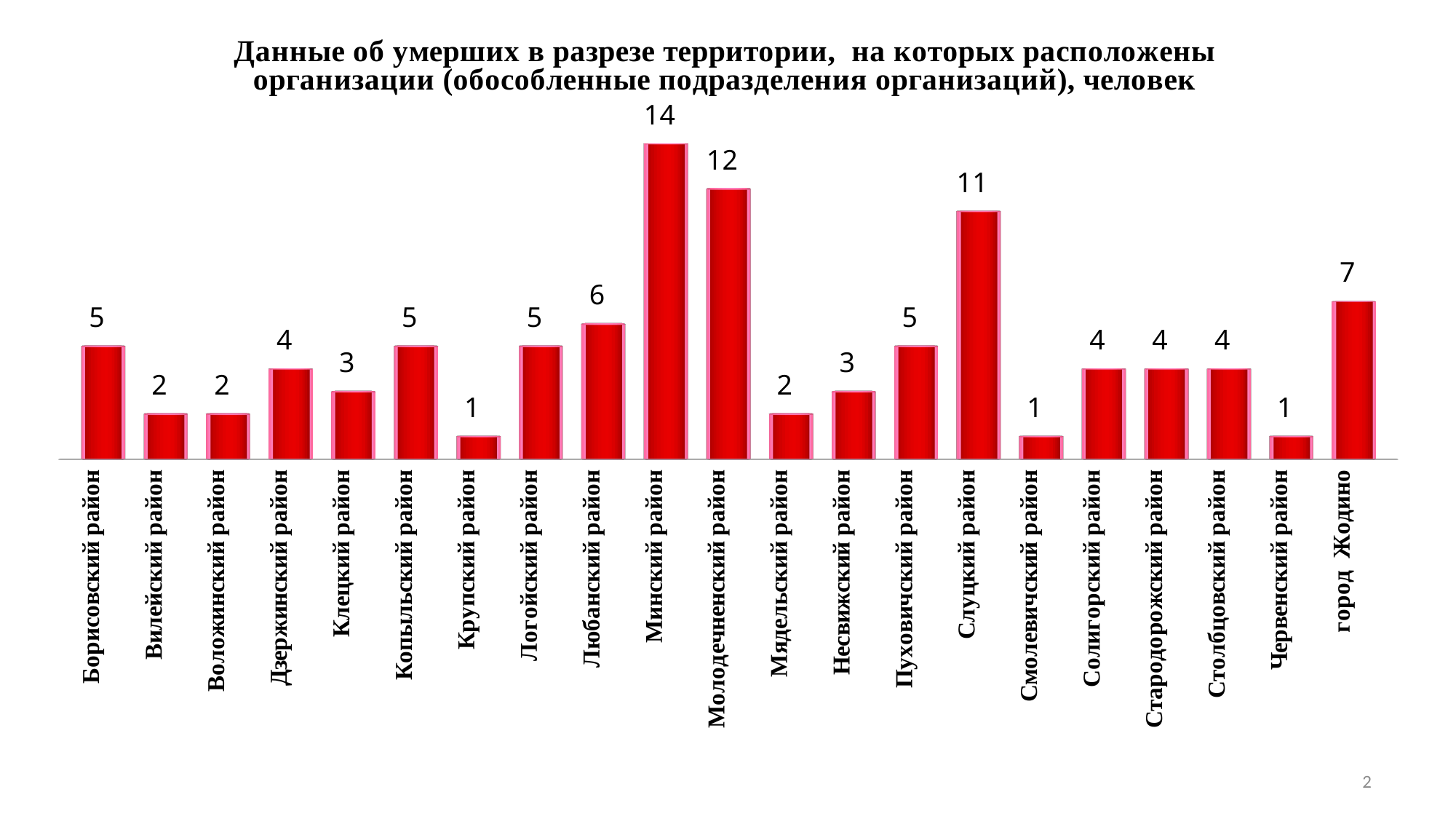
Which is larger, the value for Клецкий район or the value for Дзержинский район? Дзержинский район What is the difference between the values for Слуцкий район and город Жодино? 4 What is the value for Любанский район? 6 Which category has the highest value? Минский район Which is larger, the value for Молодечненский район or the value for Слуцкий район? Молодечненский район How many categories are shown on the x axis? 21 What is the difference between the values for Минский район and Молодечненский район? 2 What kind of chart is shown on the slide? Bar chart What is the value for город Жодино? 7 What is the value for Слуцкий район? 11 What colour are the bars in the chart? Red What is the value for Минский район? 14